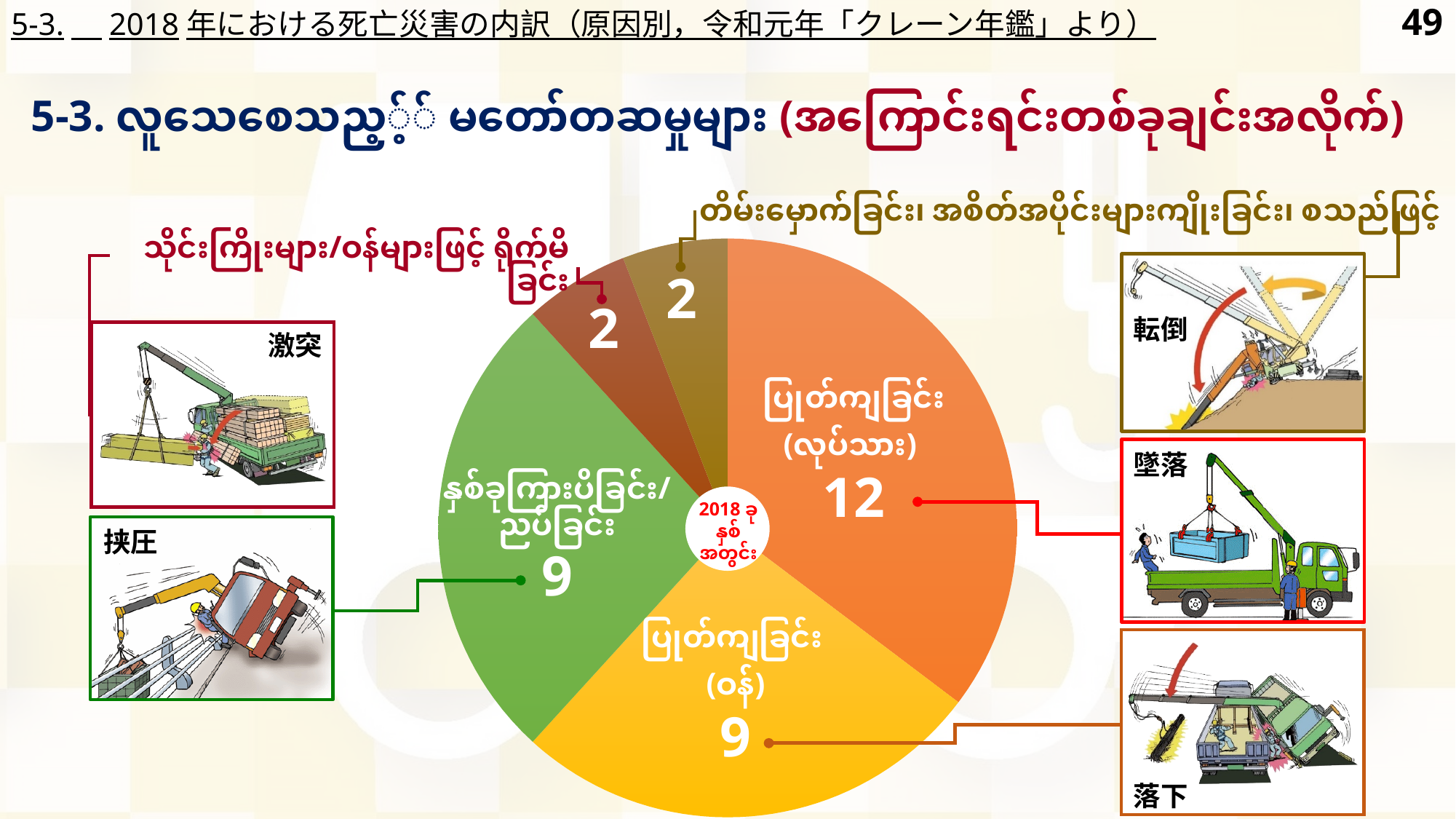
What year is written in the centre of the pie chart? 2018 What kind of chart is shown on the slide? pie chart What is the value of the largest slice of the pie chart (the orange slice linked to the 墜落 picture)? 12 What is the value of the olive slice linked to the 転倒 picture? 2 What is the value of the dark red slice linked to the 激突 picture? 2 What is the value of the yellow slice linked to the 落下 picture? 9 How many slices does the pie chart have? 5 What is the value of the green slice linked to the 挟圧 picture? 9 What is the total of all the slice values in the pie chart? 34 Which is larger, the orange slice linked to 墜落 or the green slice linked to 挟圧? the orange slice (墜落) What is the difference between the orange slice (12) and the yellow slice (9)? 3 Which slice of the pie chart has the highest value? the orange slice (墜落), 12